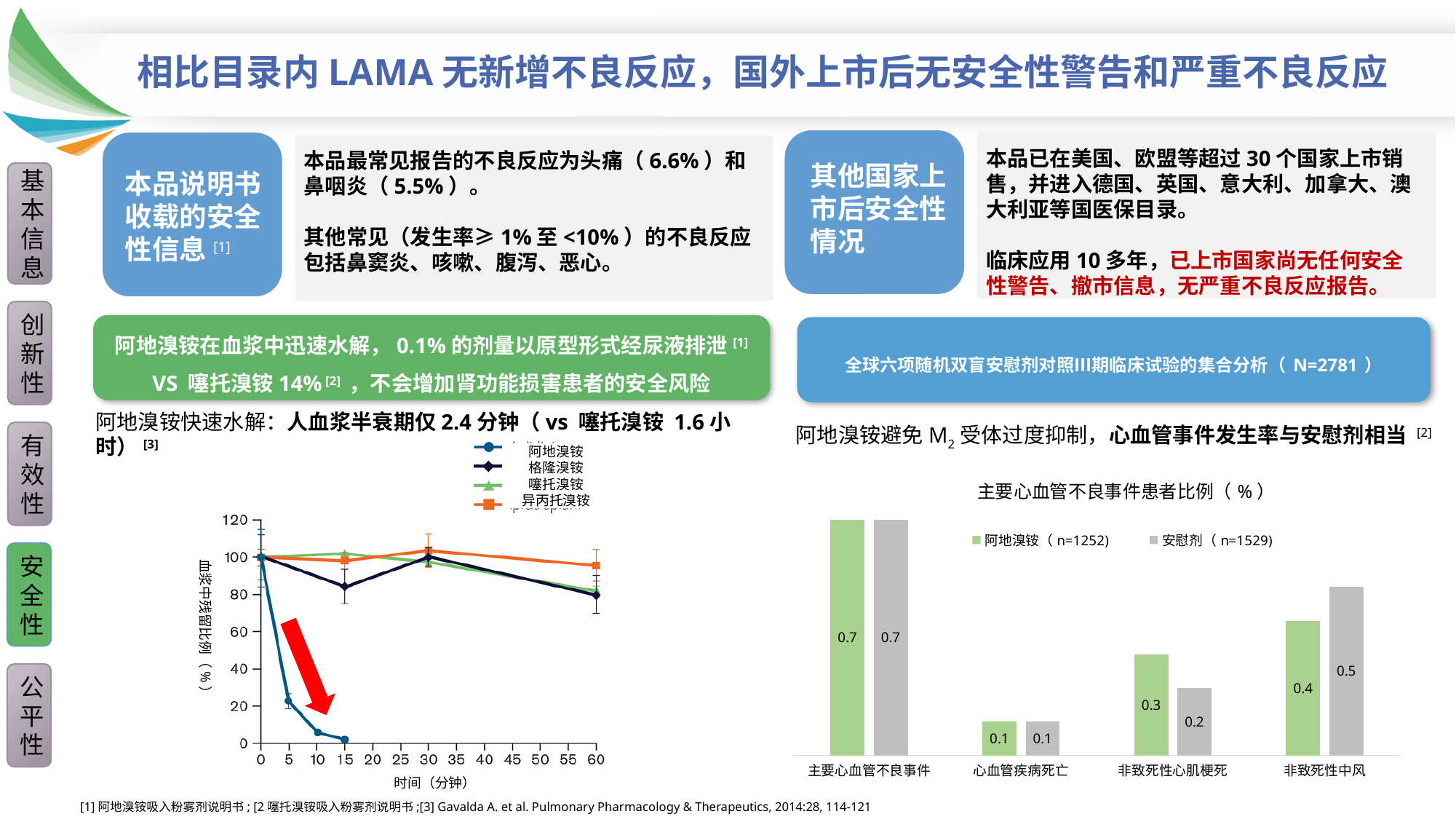
What kind of chart is the chart on the left side of the slide showing 血浆中残留比例 over 时间（分钟）? line chart In the bar chart titled 主要心血管不良事件患者比例（%）, which category has the lowest value for 安慰剂? 心血管疾病死亡 In the bar chart titled 主要心血管不良事件患者比例（%）, what is the value for 安慰剂 in the 非致死性中风 category? 0.5 In the line chart on the left side of the slide, is the value for 阿地溴铵 at 15 minutes greater or less than 20? less In the bar chart titled 主要心血管不良事件患者比例（%）, which category has the highest value for 阿地溴铵? 主要心血管不良事件 In the bar chart titled 主要心血管不良事件患者比例（%）, what is the value for 阿地溴铵 in the 非致死性心肌梗死 category? 0.3 In the bar chart titled 主要心血管不良事件患者比例（%）, which is larger in the 非致死性中风 category, 阿地溴铵 or 安慰剂? 安慰剂 In the bar chart titled 主要心血管不良事件患者比例（%）, what is the value for 阿地溴铵 in the 主要心血管不良事件 category? 0.7 How many categories are shown on the x axis of the bar chart titled 主要心血管不良事件患者比例（%）? 4 How many series does the legend of the line chart on the left side of the slide list? 4 How many series does the legend of the bar chart titled 主要心血管不良事件患者比例（%） list? 2 In the bar chart titled 主要心血管不良事件患者比例（%）, what is the difference between 阿地溴铵 and 安慰剂 in the 非致死性心肌梗死 category? 0.1